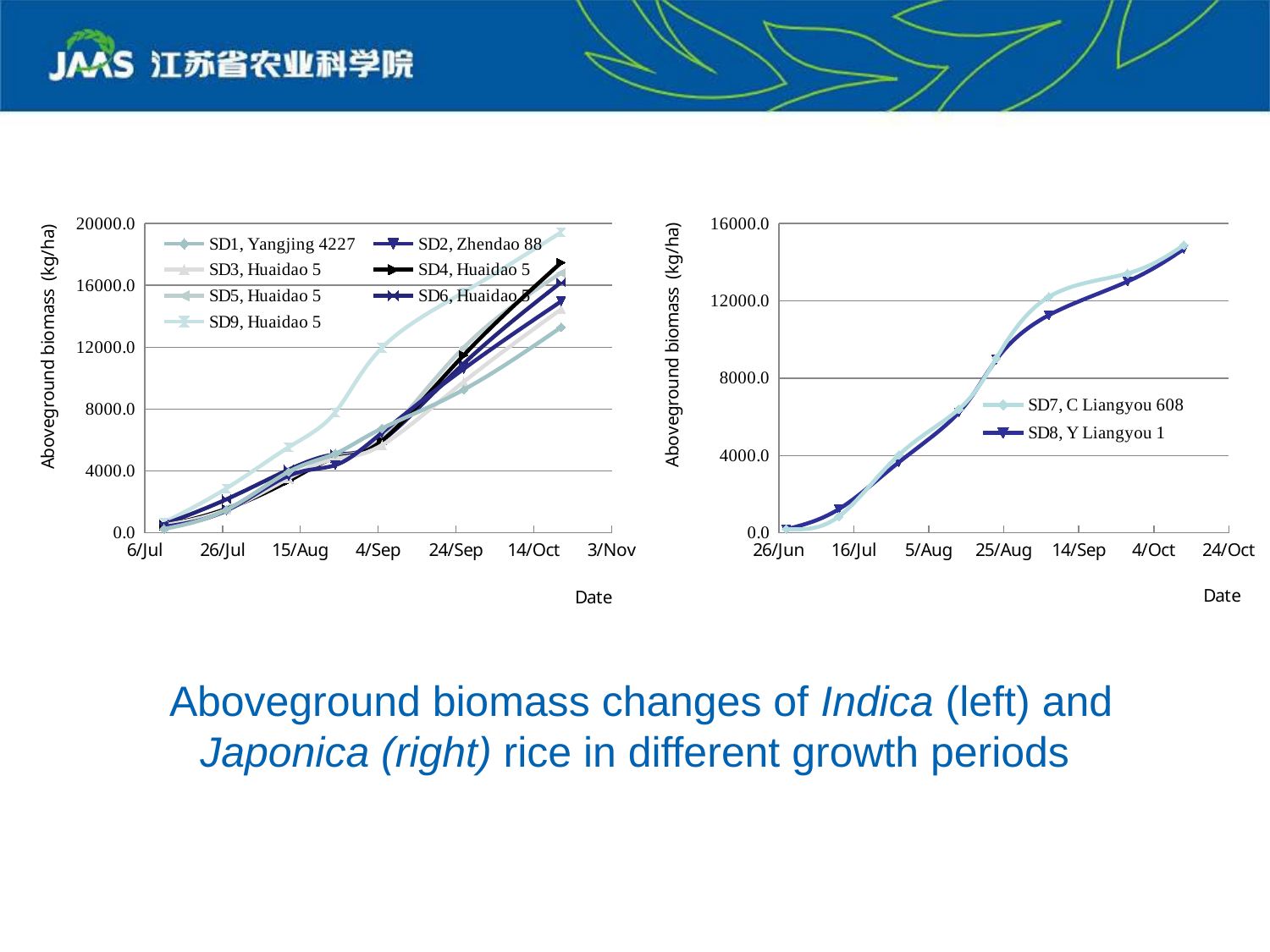
What kind of chart is the right chart? line chart In the right chart, does the SD8, Y Liangyou 1 series rise or fall from 26/Jun to its last point? rise In the left chart, is the final value of SD9, Huaidao 5 greater or less than 16000.0? greater What kind of chart is the left chart? line chart In the right chart, is the final value of SD7, C Liangyou 608 greater or less than 12000.0? greater How many series does the legend of the left chart list? 7 How many series does the legend of the right chart list? 2 In the left chart, which series has the highest value at the last date plotted? SD9, Huaidao 5 In the right chart, which variety is listed in the legend for SD8? Y Liangyou 1 What is the y-axis label of the right chart? Aboveground biomass (kg/ha) In the left chart, do the biomass values rise or fall along the x axis over time? rise In the left chart, is the final value of SD1, Yangjing 4227 greater or less than 16000.0? less